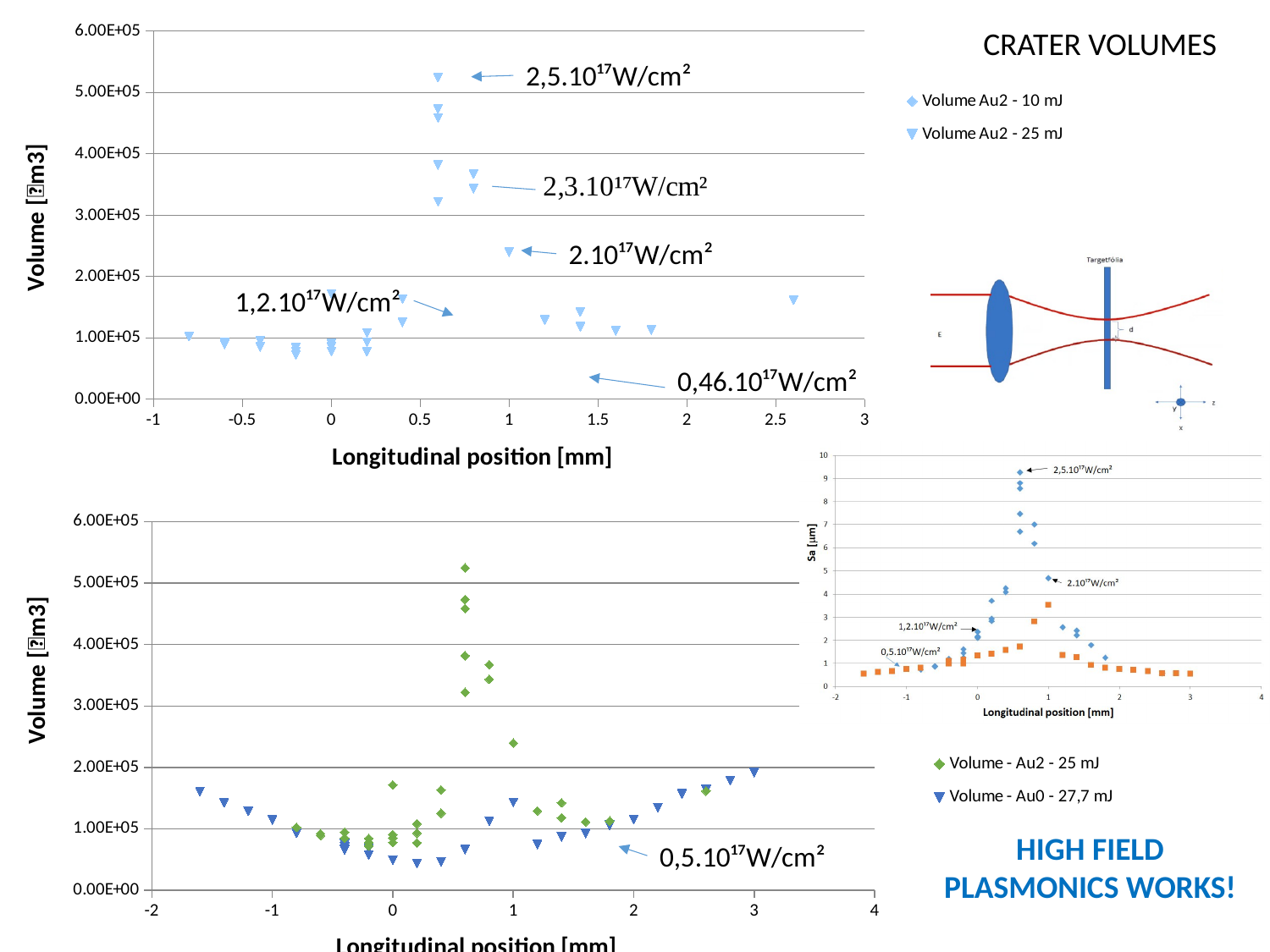
In the small inset chart on the right, is the highest Sa value greater or less than 9? greater How many series does the legend of the top-left chart list? 2 How many series does the legend of the bottom-left chart list? 2 What is the y-axis label of the small inset chart on the right? Sa [µm] What is the title shown above the legend of the top-left chart? CRATER VOLUMES In the bottom-left chart, is the highest value of the Volume - Au2 - 25 mJ series greater or less than 5.00E+05? greater In the top-left chart, is the highest plotted volume greater or less than 5.00E+05? greater What kind of chart is the top-left chart on the slide? scatter chart In the bottom-left chart, which series reaches the higher maximum volume: Volume - Au2 - 25 mJ or Volume - Au0 - 27,7 mJ? Volume - Au2 - 25 mJ What is the x-axis label of the top-left chart? Longitudinal position [mm]